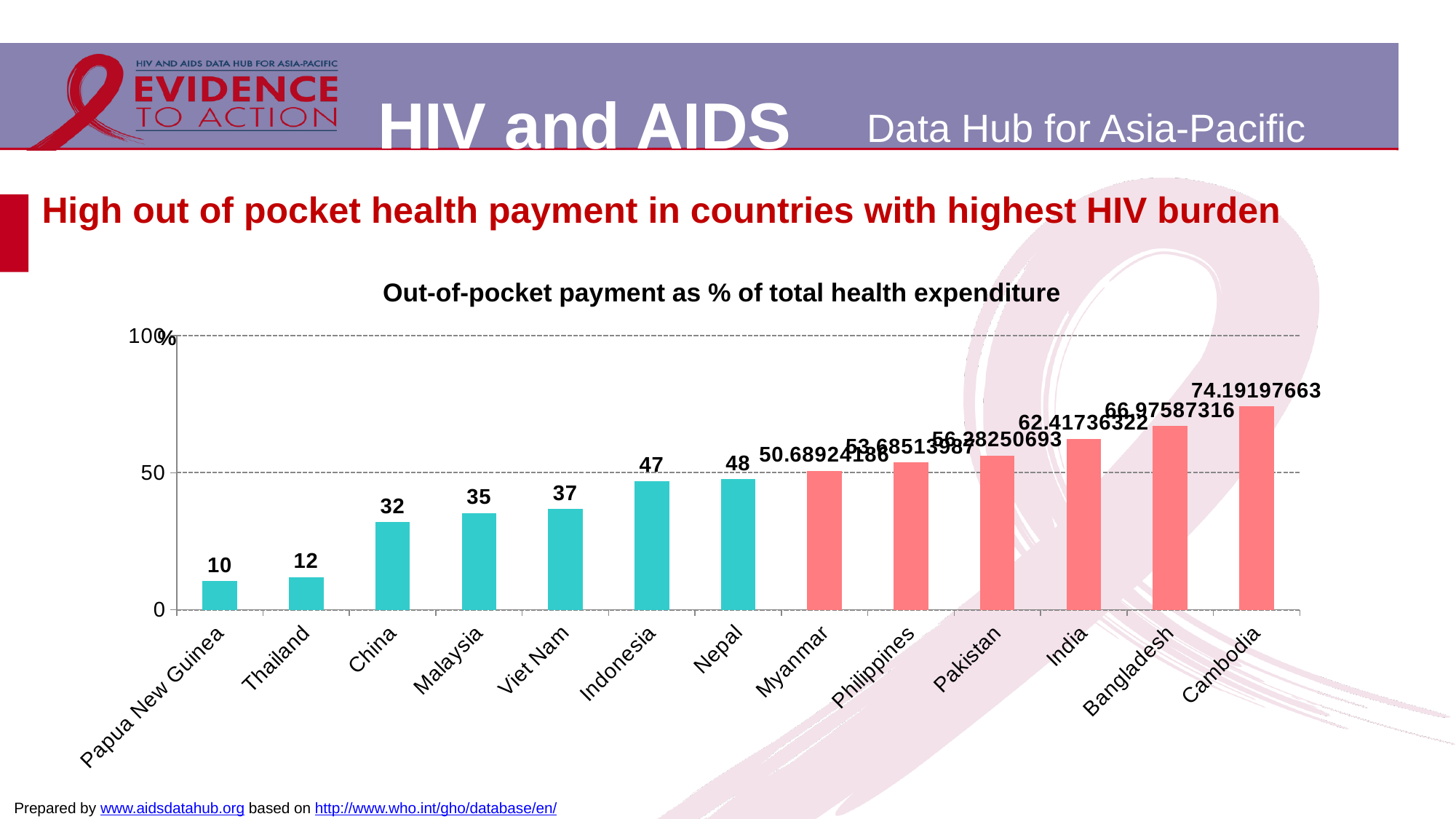
What is the difference between the values for Malaysia and China? 3 What is the out-of-pocket payment as % of total health expenditure for China? 32 What value is shown for Cambodia? 74.19197663 Which has a higher value, Thailand or Malaysia? Malaysia Which country has the lowest out-of-pocket payment share? Papua New Guinea Is the value for India greater or less than 50? greater What value is shown for Viet Nam? 37 What type of chart is shown on the slide? Bar chart What value is shown for Papua New Guinea? 10 What is the difference between the values for Nepal and Indonesia? 1 Which country has the highest out-of-pocket payment share? Cambodia How many countries are shown on the x axis? 13